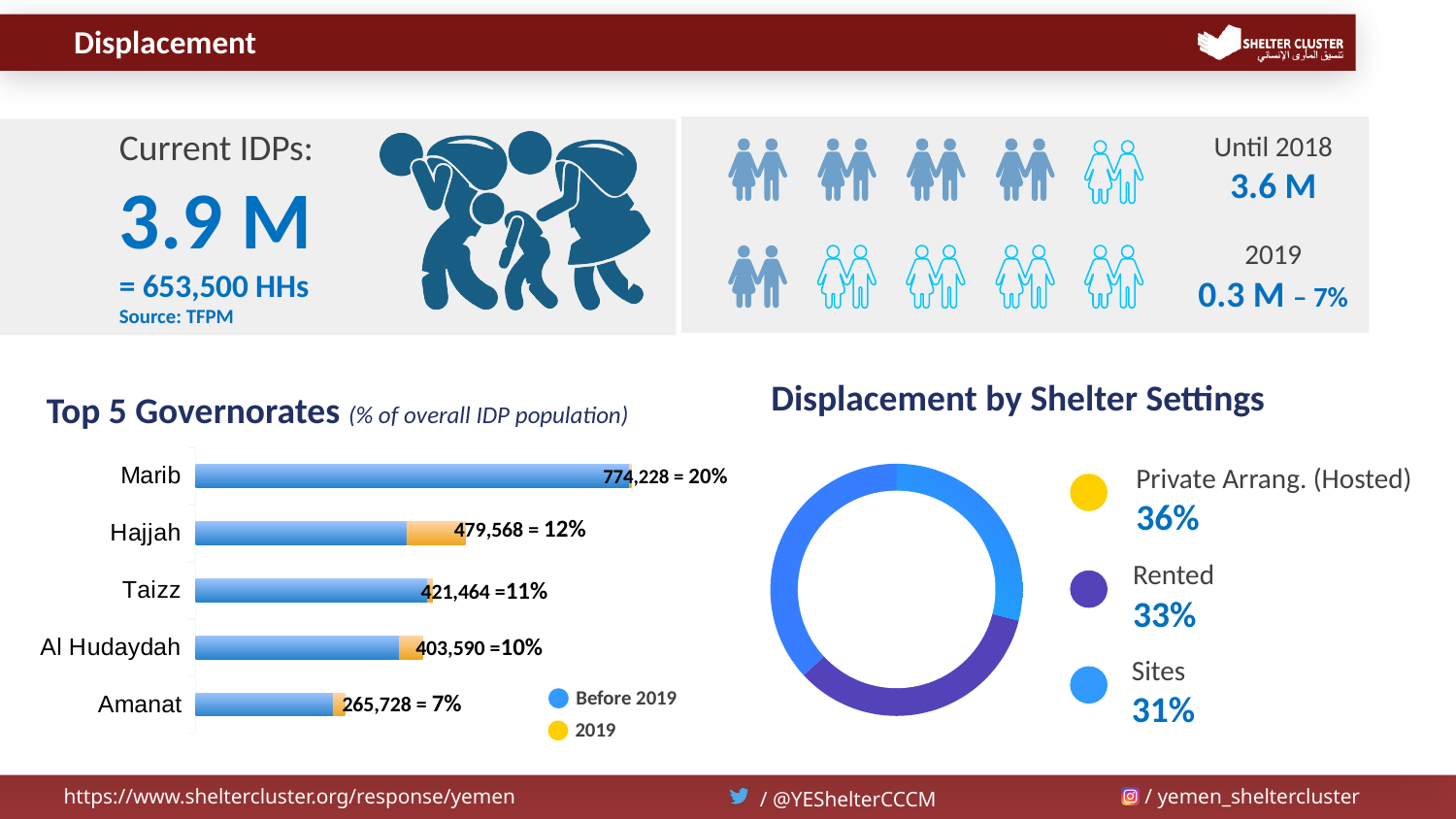
In the Top 5 Governorates chart, what is the difference between the values for Marib and Hajjah? 294,660 In the Displacement by Shelter Settings chart, which shelter setting has the largest share? Private Arrang. (Hosted) In the Top 5 Governorates chart, which governorate has the lowest value? Amanat In the Top 5 Governorates chart, which has a larger value, Taizz or Al Hudaydah? Taizz In the Top 5 Governorates chart, what percentage of the overall IDP population is shown for Hajjah? 12% How many series does the legend of the Top 5 Governorates chart list? 2 How many governorates are shown in the Top 5 Governorates chart? 5 In the Displacement by Shelter Settings chart, what share is shown for Rented? 33% In the Displacement by Shelter Settings chart, what is the difference between the shares for Private Arrang. (Hosted) and Sites? 5% In the Top 5 Governorates chart, which governorate has the highest value? Marib What kind of chart is the Top 5 Governorates chart? Bar chart In the Top 5 Governorates chart, what is the number of IDPs shown for Marib? 774,228